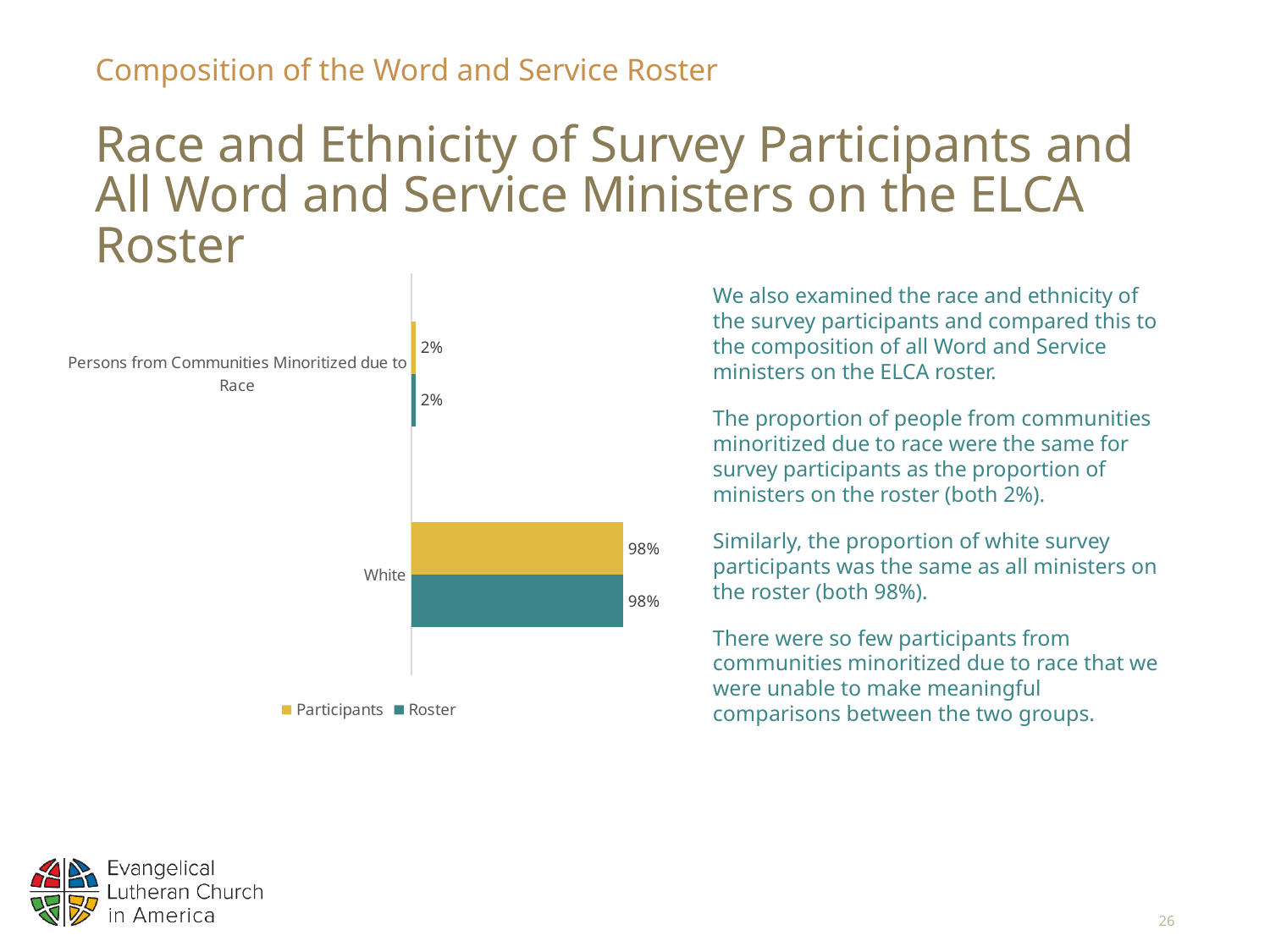
How many categories are shown on the chart? 2 What is the Roster value for Persons from Communities Minoritized due to Race? 2% What is the Roster value for White? 98% What are the two series named in the legend? Participants and Roster Which category has the highest Participants value? White Which category has the lowest Roster value? Persons from Communities Minoritized due to Race How many series does the legend list? 2 What is the Participants value for White? 98% What is the Participants value for Persons from Communities Minoritized due to Race? 2% What is the difference between the Participants values for White and Persons from Communities Minoritized due to Race? 96% Is the Roster value for White larger or smaller than the Roster value for Persons from Communities Minoritized due to Race? larger What kind of chart is shown on the slide? bar chart